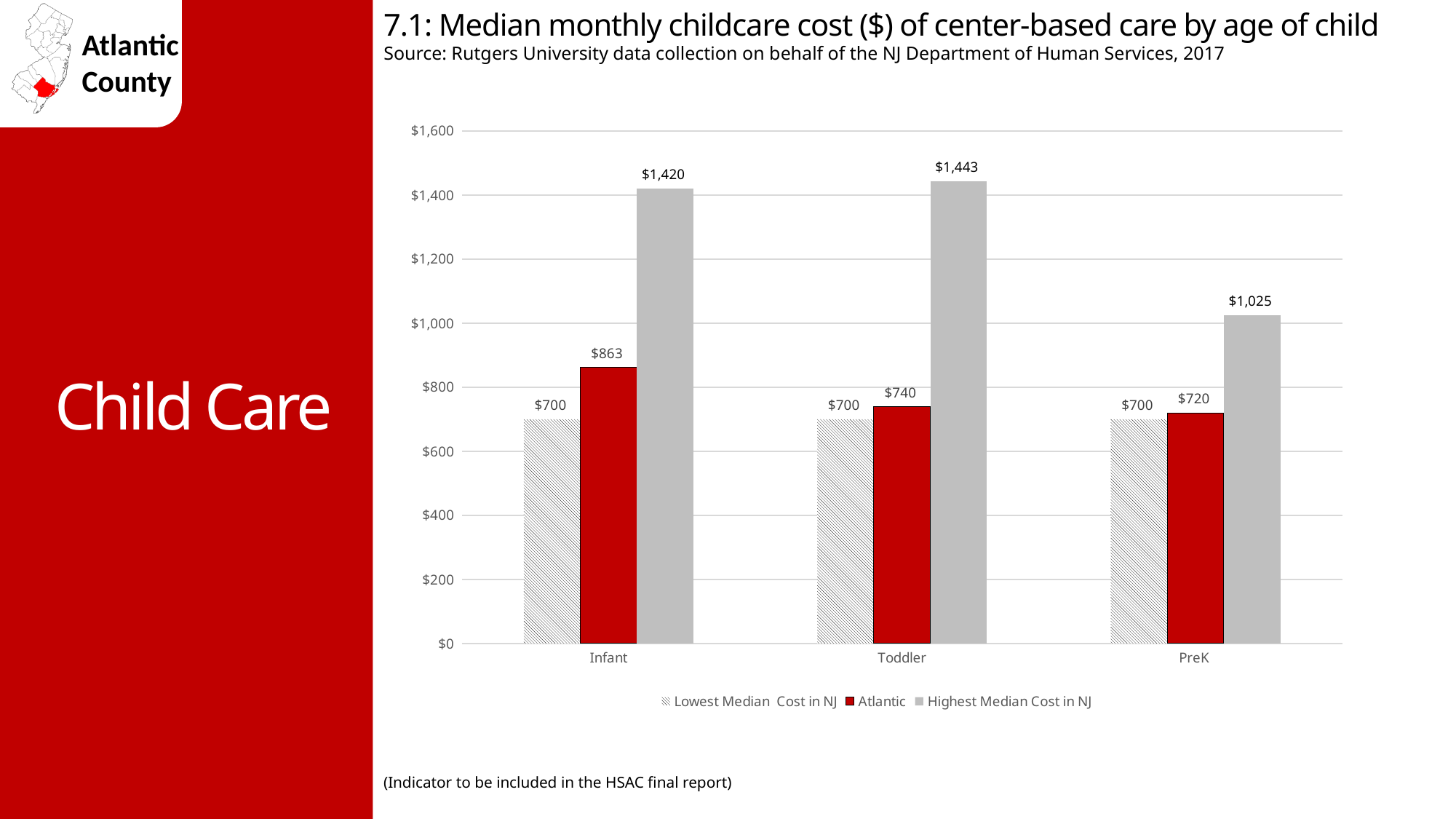
How many age groups are shown on the x axis? 3 What is the difference between the Highest Median Cost in NJ and the Atlantic cost for Infant care? $557 Which age group has the lowest Highest Median Cost in NJ? PreK What is the median monthly childcare cost for Atlantic for Infant care? $863 Which age group has the highest Atlantic median monthly cost? Infant How many series does the legend list? 3 Which is larger: the Atlantic cost for Toddler care or the Atlantic cost for PreK care? Toddler What kind of chart is shown on the slide? Bar chart What is the Lowest Median Cost in NJ for PreK care? $700 Is the Highest Median Cost in NJ for PreK care greater or less than $1,000? greater Which series is drawn in red? Atlantic What is the Highest Median Cost in NJ for Toddler care? $1,443